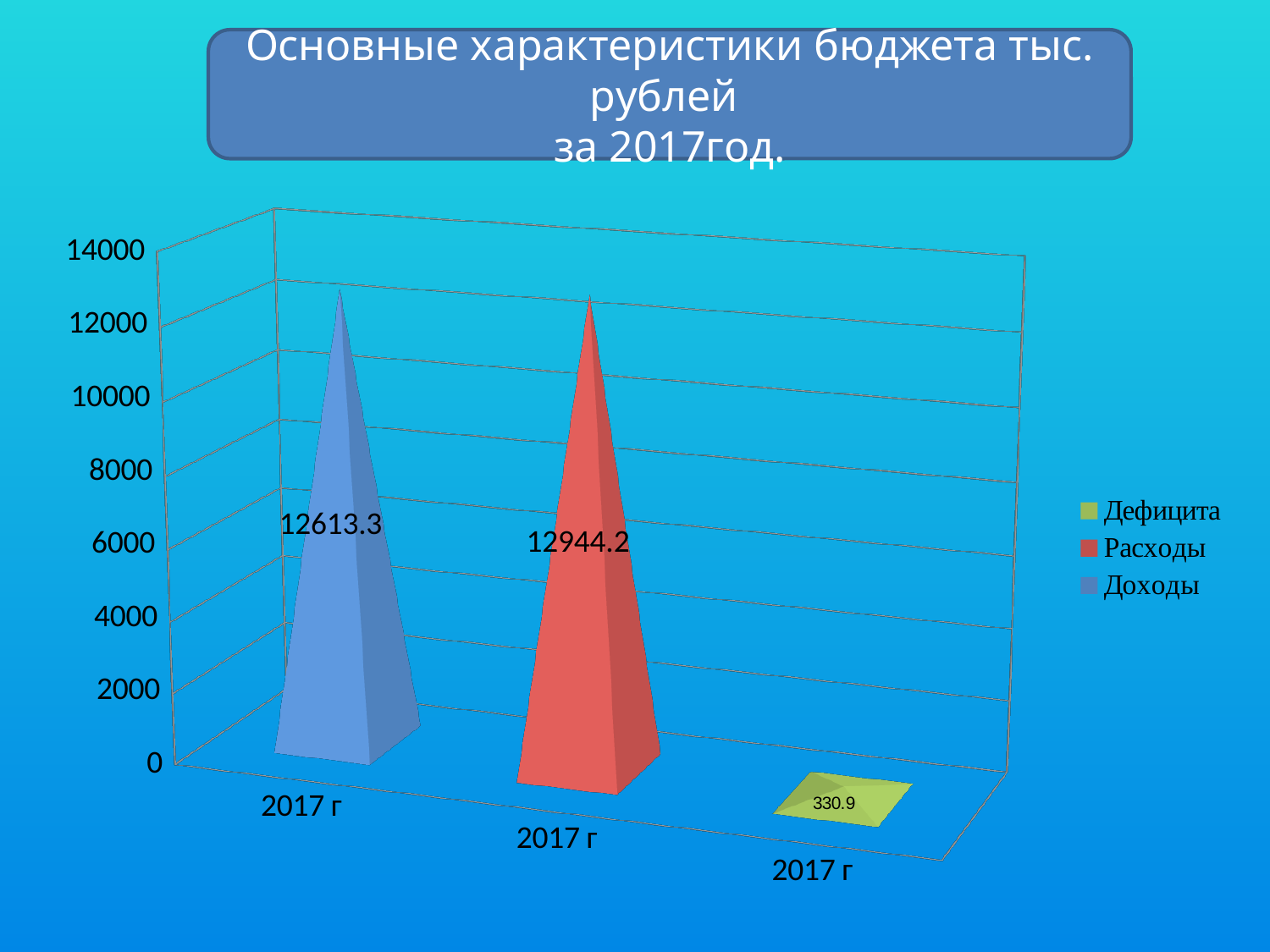
Which is larger, Доходы or Расходы? Расходы How many series does the legend list? 3 Is the value for Доходы greater or less than 12000? greater Which series has the lowest value? Дефицита What is the value for Расходы? 12944.2 Which series has the highest value? Расходы Is the value for Дефицита greater or less than 2000? less What is the value for Доходы? 12613.3 What is the value for Дефицита? 330.9 What kind of chart is shown on the slide? bar chart What colour represents Расходы in the chart? red What is the difference between Расходы and Доходы? 330.9